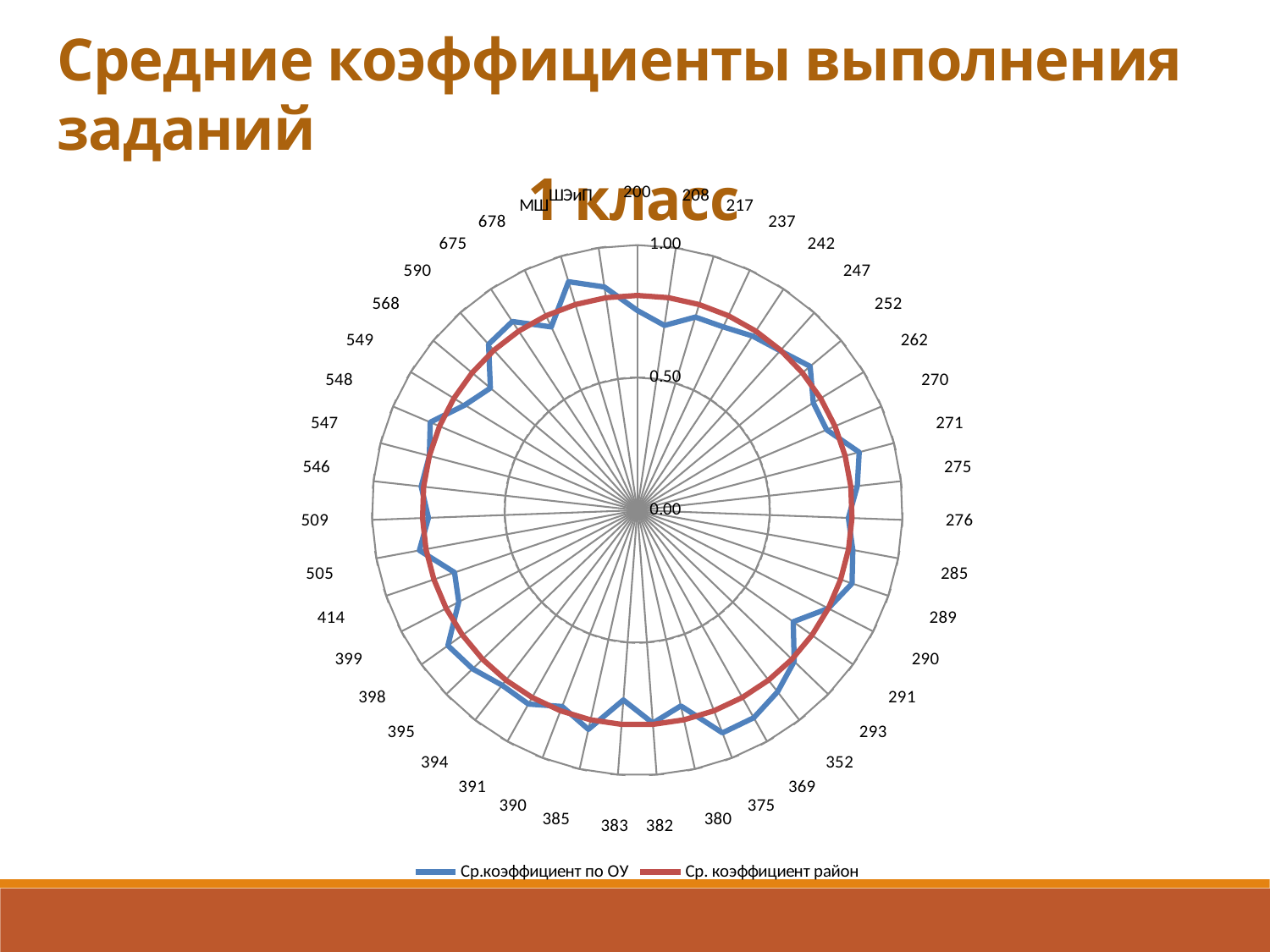
What kind of chart is shown on the slide? radar chart Is the value of Ср.коэффициент по ОУ for category 276 greater or less than 0.50? greater For category 505, which series has the larger value: Ср.коэффициент по ОУ or Ср. коэффициент район? Ср.коэффициент по ОУ For category 276, which series has the larger value: Ср.коэффициент по ОУ or Ср. коэффициент район? Ср. коэффициент район Which series is drawn in red on the chart? Ср. коэффициент район Is the value of Ср.коэффициент по ОУ for category 505 greater or less than 1.00? less Is the value of Ср.коэффициент по ОУ for category 414 greater or less than 0.50? greater For category 271, which series has the larger value: Ср.коэффициент по ОУ or Ср. коэффициент район? Ср.коэффициент по ОУ How many series does the chart legend list? 2 What is the title of the chart? 1 класс